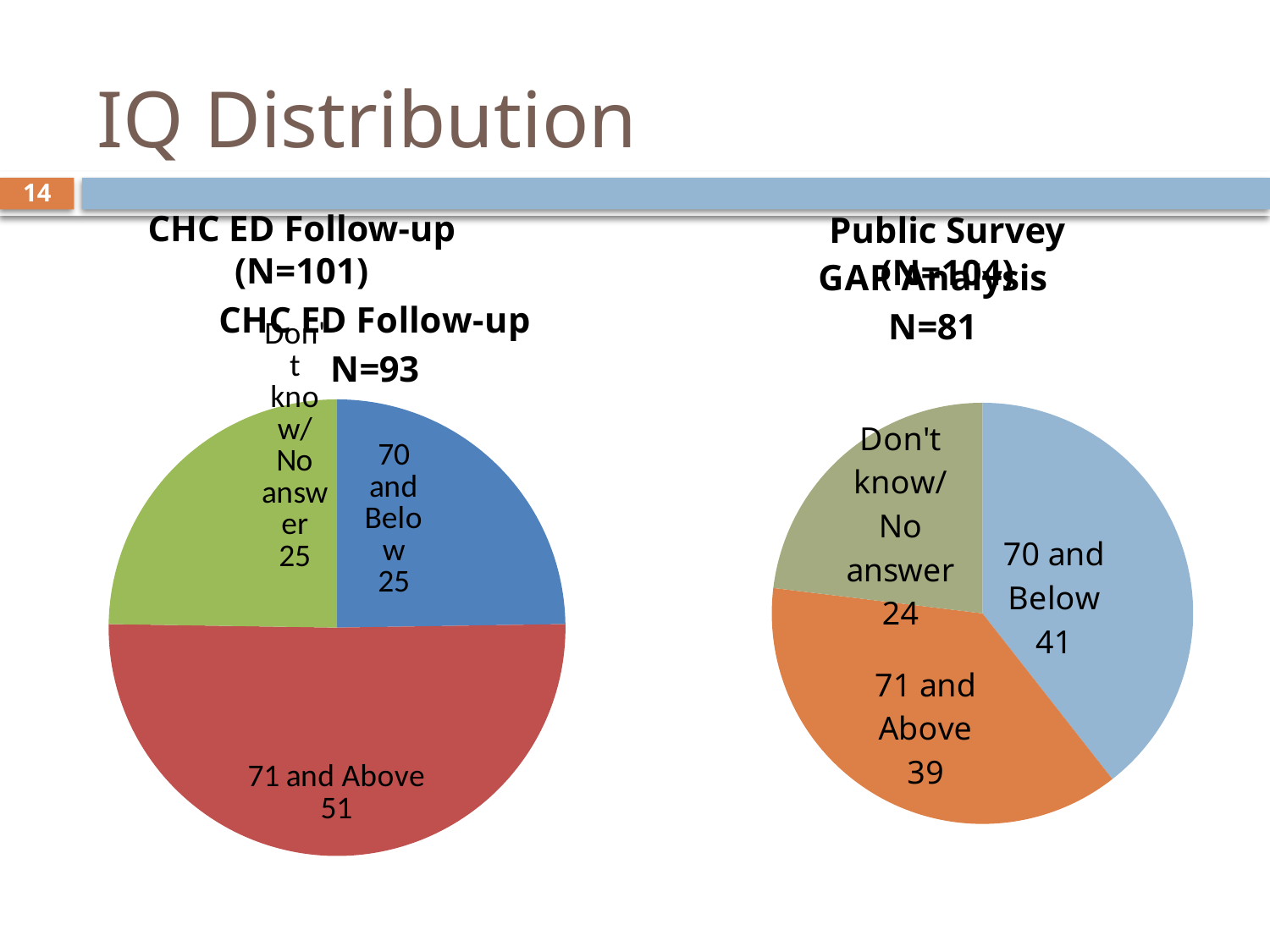
In the right pie chart, what is the value for 70 and Below? 41 In the left pie chart, what is the value for 71 and Above? 51 In the right pie chart, which is larger: 70 and Below or 71 and Above? 70 and Below In the left pie chart, which category has the largest slice? 71 and Above How many slices does the left pie chart have? 3 What kind of chart is the left chart on the slide? pie chart In the left pie chart, what is the value for 70 and Below? 25 What is the sum of the three values shown in the right pie chart? 104 In the right pie chart, which category has the smallest slice? Don't know/No answer In the right pie chart, what is the value for Don't know/No answer? 24 In the left pie chart, what is the difference between 71 and Above and Don't know/No answer? 26 In the right pie chart, what is the difference between 70 and Below and 71 and Above? 2